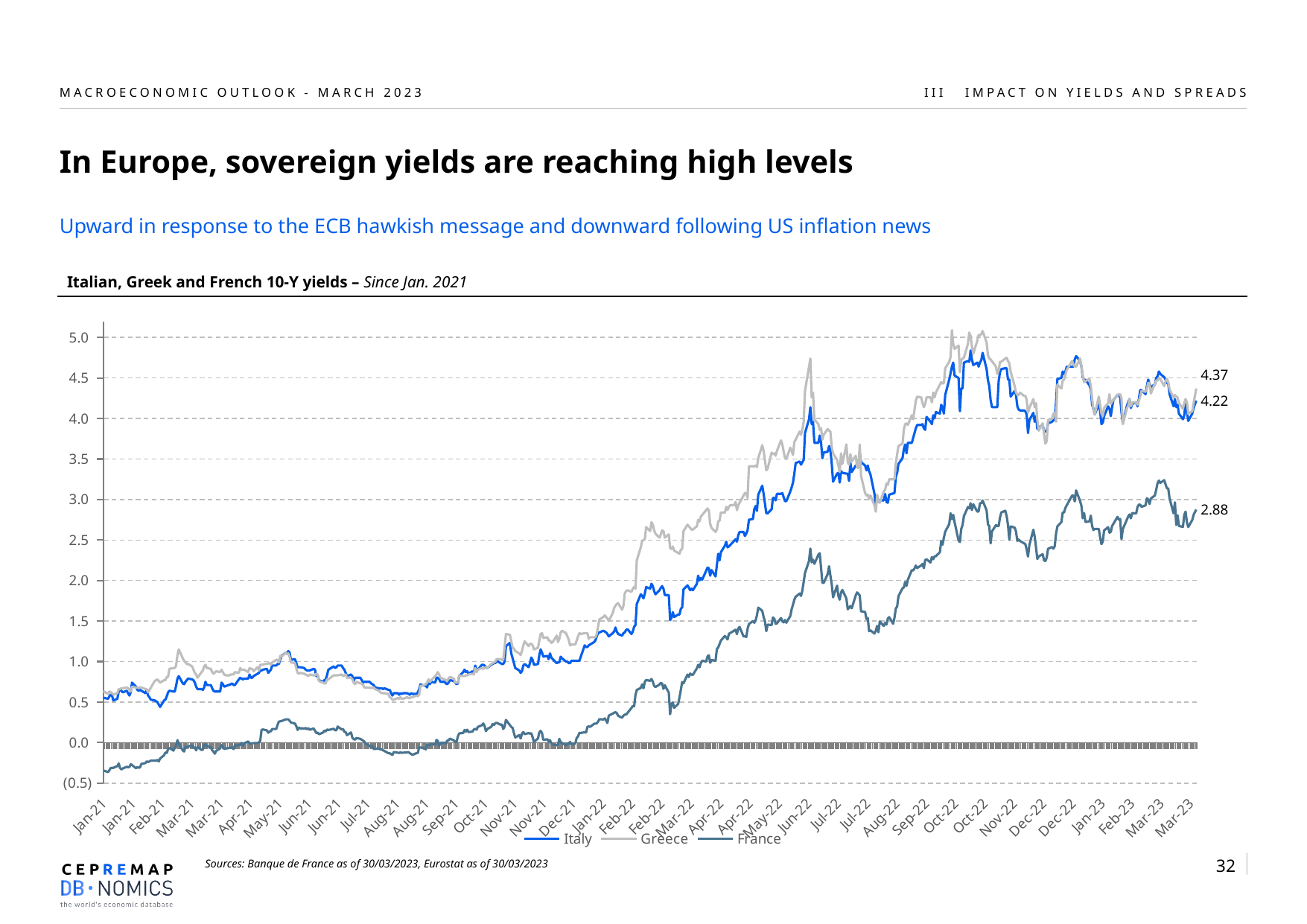
Which series has the lowest value at the end of the period? France What is the latest value shown for the Greek 10-Y yield? 4.37 What kind of chart is shown on the slide? line chart What is the title of the chart? Italian, Greek and French 10-Y yields – Since Jan. 2021 How many series does the legend list? 3 At the end of the period, is the Italian yield or the French yield higher? Italy What is the latest value shown for the Italian 10-Y yield? 4.22 What is the difference between the latest Greek and French yields shown? 1.49 Is the French yield in Jan-21 greater or less than 0.0? less What is the difference between the latest Italian and French yields shown? 1.34 Overall, do the yields rise or fall from Jan-21 to Mar-23? rise What is the latest value shown for the French 10-Y yield? 2.88